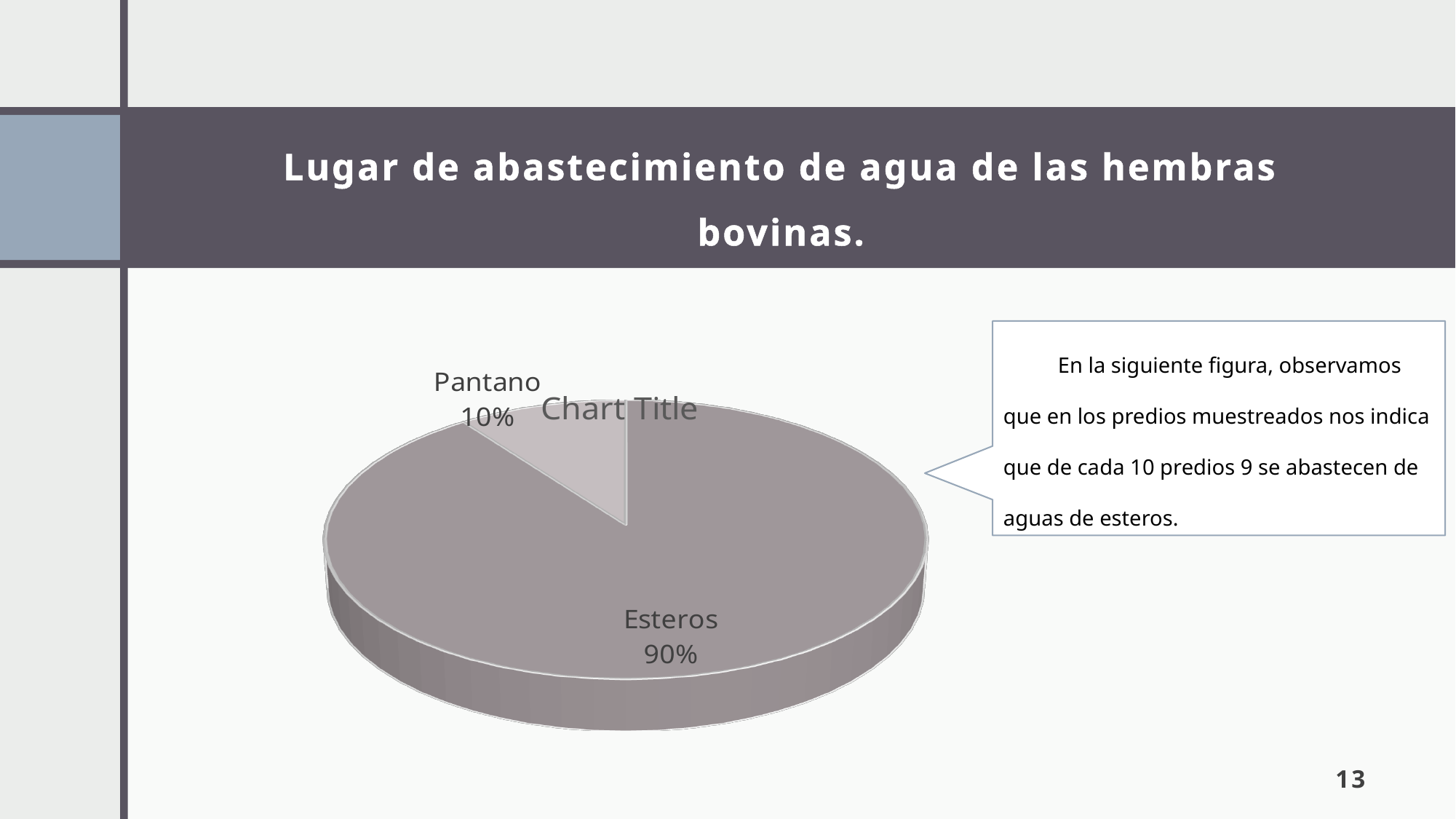
What is the difference in percentage points between Esteros and Pantano? 80 percentage points Which category has the smallest slice of the pie? Pantano What share of the pie does Pantano represent? 10% What is the title printed inside the chart area? Chart Title Which category has the largest slice of the pie? Esteros What share of the pie does Esteros represent? 90% How many categories are shown in the pie chart? 2 Which is larger, the slice for Esteros or the slice for Pantano? Esteros What kind of chart is shown on the slide? pie chart What is the title of the slide? Lugar de abastecimiento de agua de las hembras bovinas.